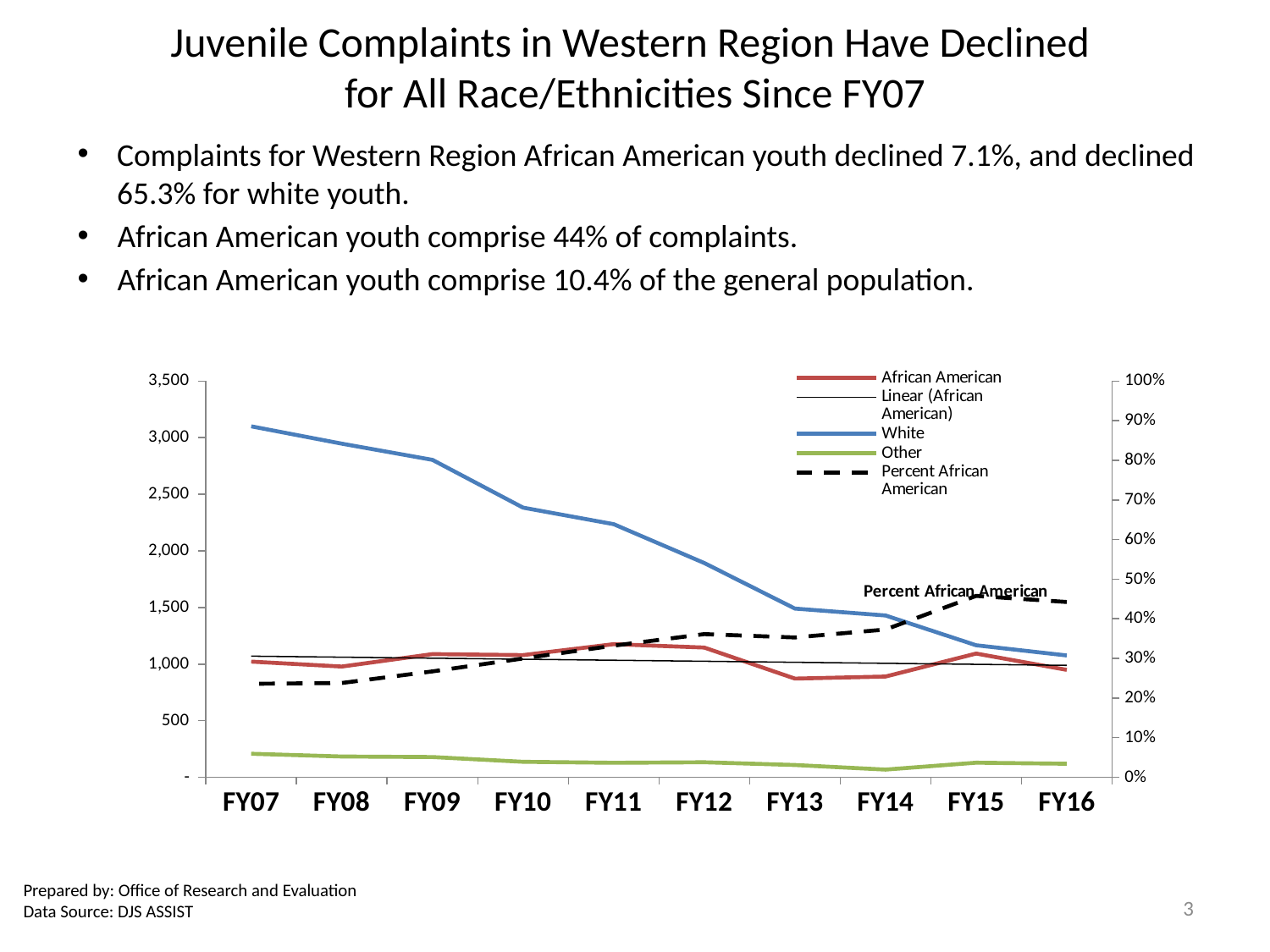
Which series has the lowest values on the left axis across all years? Other In which fiscal year is the White series at its highest? FY07 Is the African American value for FY13 greater or less than 1,000? less What kind of chart is shown on the slide? line chart How many series does the chart legend list? 5 Does the White series rise or fall from FY07 to FY16? fall Which series is drawn as a dashed black line? Percent African American Is the White value for FY10 greater or less than 2,500? less Is the Percent African American value for FY15 greater or less than 40%? greater In FY07, which is larger: the White value or the African American value? White How many fiscal years are plotted along the x axis? 10